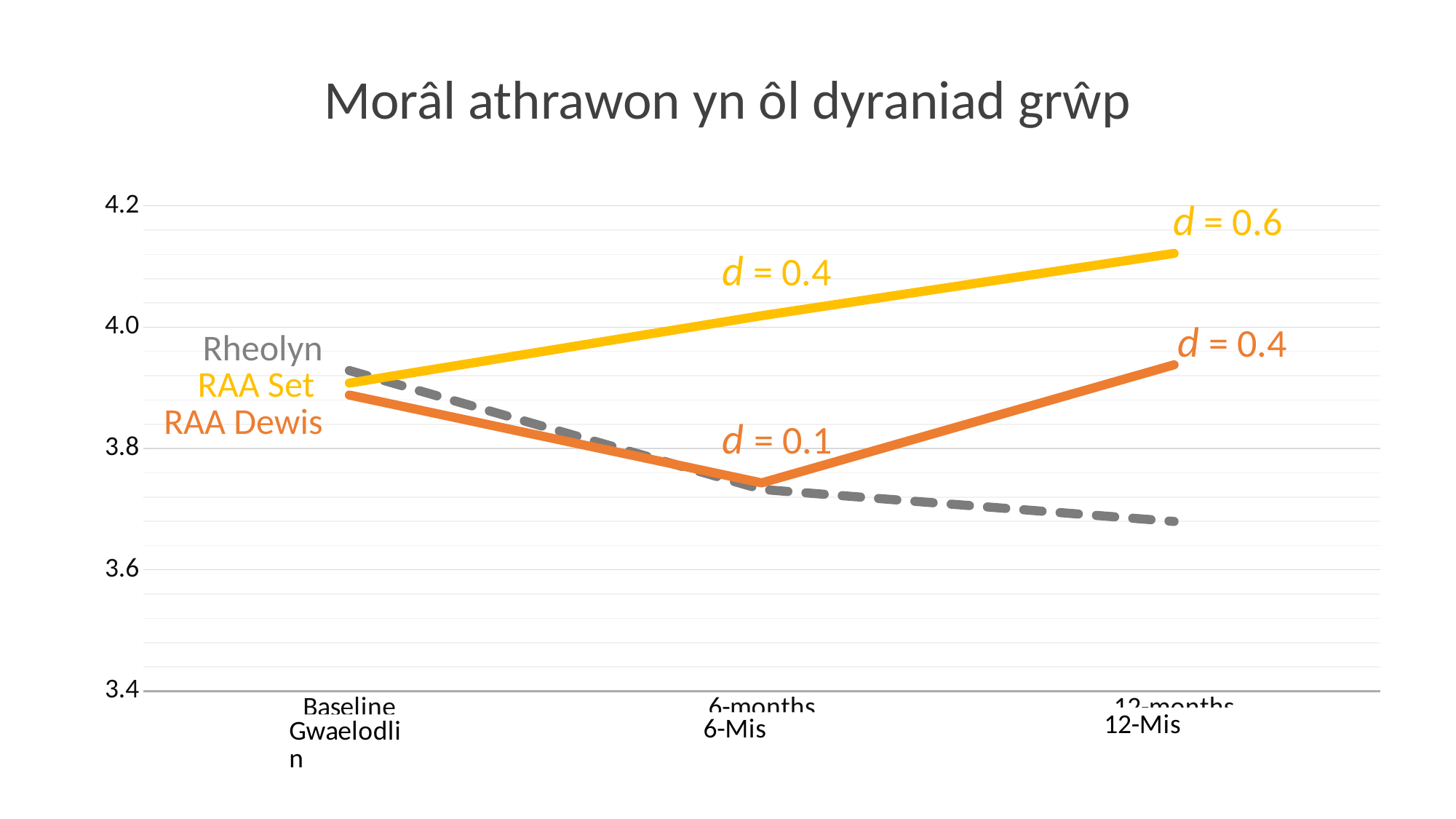
Which group has the highest value at 12-Mis? RAA Set How many time points are plotted along the x axis? 3 Does the Rheolyn line rise or fall from Gwaelodlin to 12-Mis? falls Is the value for Rheolyn at 12-Mis greater or less than 3.8? less How many groups (series) are plotted on the chart? 3 At 6-Mis, which is larger: RAA Set or RAA Dewis? RAA Set Which group has the lowest value at 12-Mis? Rheolyn Is the value for RAA Dewis at 12-Mis greater or less than 4.0? less What effect size (d) is annotated for RAA Set at 12-Mis? d = 0.6 Does the RAA Set line rise or fall from Gwaelodlin to 12-Mis? rises What kind of chart is shown on the slide? line chart Is the value for RAA Set at 12-Mis greater or less than 4.0? greater